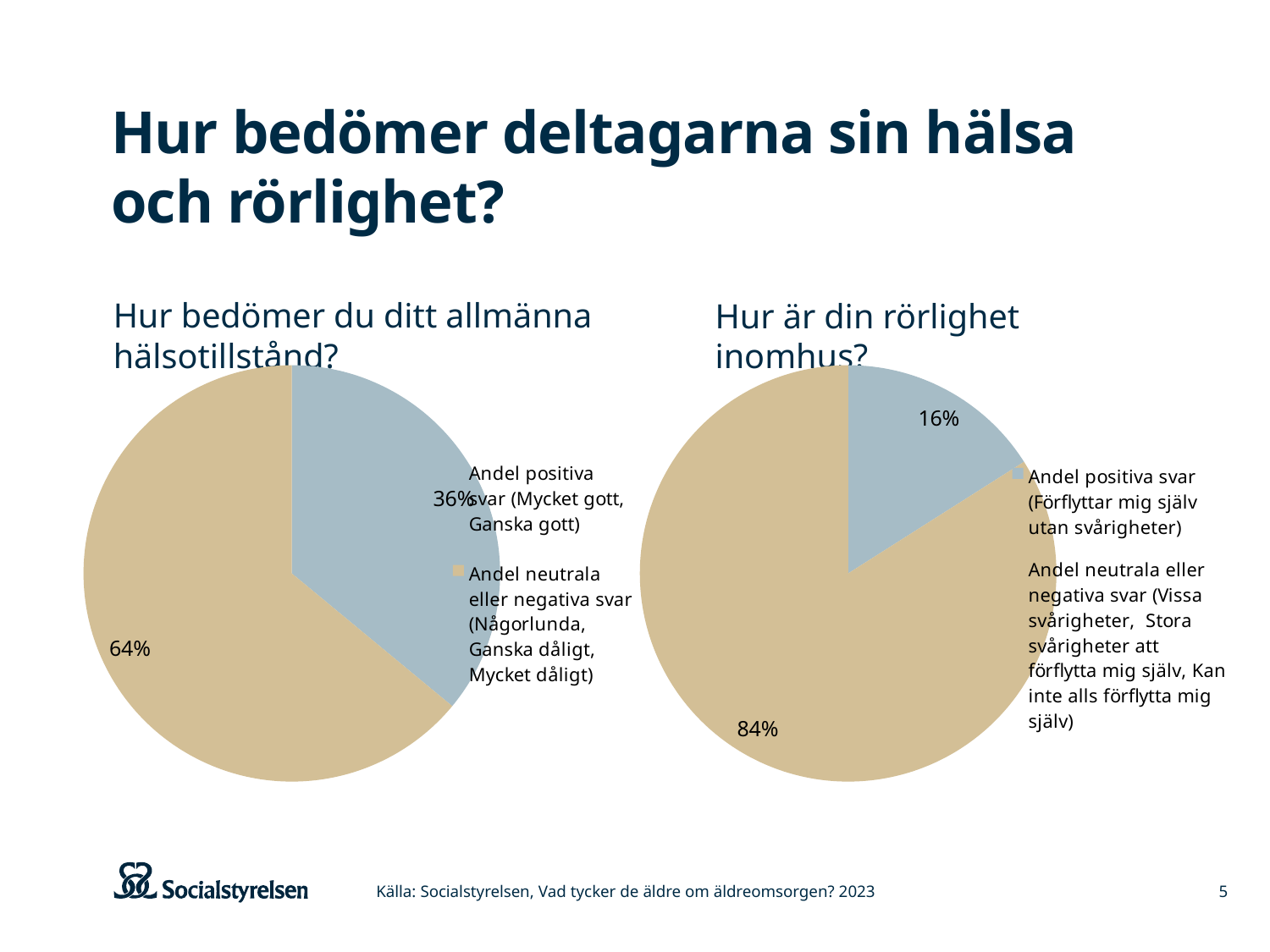
In the chart 'Hur är din rörlighet inomhus?', what share is 'Andel positiva svar (Förflyttar mig själv utan svårigheter)'? 16% In the chart 'Hur bedömer du ditt allmänna hälsotillstånd?', what share is 'Andel neutrala eller negativa svar'? 64% In the chart 'Hur bedömer du ditt allmänna hälsotillstånd?', what is the difference between the neutral/negative share and the positive share? 28% How many pie charts are shown on the slide? 2 Which chart has the larger positive share: 'Hur bedömer du ditt allmänna hälsotillstånd?' or 'Hur är din rörlighet inomhus?'? Hur bedömer du ditt allmänna hälsotillstånd? How many slices does the chart 'Hur är din rörlighet inomhus?' have? 2 In the chart 'Hur är din rörlighet inomhus?', which slice is the largest? Andel neutrala eller negativa svar What kind of chart is used for 'Hur bedömer du ditt allmänna hälsotillstånd?'? pie chart In the chart 'Hur är din rörlighet inomhus?', what share is 'Andel neutrala eller negativa svar'? 84% In the chart 'Hur bedömer du ditt allmänna hälsotillstånd?', which slice is the smallest? Andel positiva svar (Mycket gott, Ganska gott) In the chart 'Hur bedömer du ditt allmänna hälsotillstånd?', what share is 'Andel positiva svar (Mycket gott, Ganska gott)'? 36% In the chart 'Hur är din rörlighet inomhus?', what is the difference between the neutral/negative share and the positive share? 68%